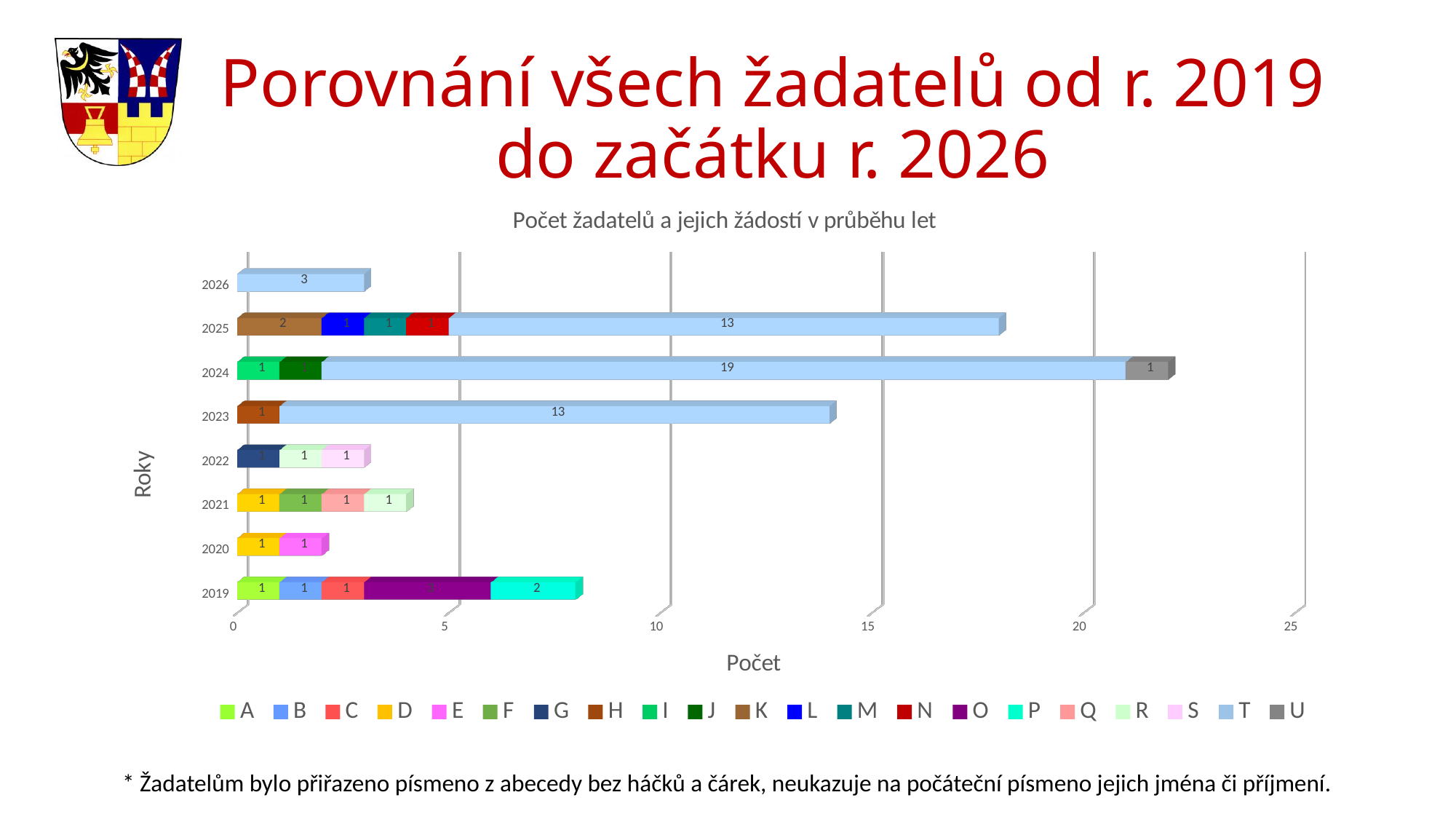
What is the difference between the value for series T in 2024 and in 2023? 6 What is the value for series O in 2019? 3 What is the total of the stacked bar for 2025? 18 What kind of chart is shown on the slide? bar chart What is the value for series T in 2026? 3 How many series does the legend list? 21 How many years are shown on the vertical axis of the chart? 8 What is the value for series T in 2025? 13 What is the total of the stacked bar for 2024? 22 What is the value for series T in 2024? 19 What is the title of the chart? Počet žadatelů a jejich žádostí v průběhu let Which year has the longest stacked bar? 2024